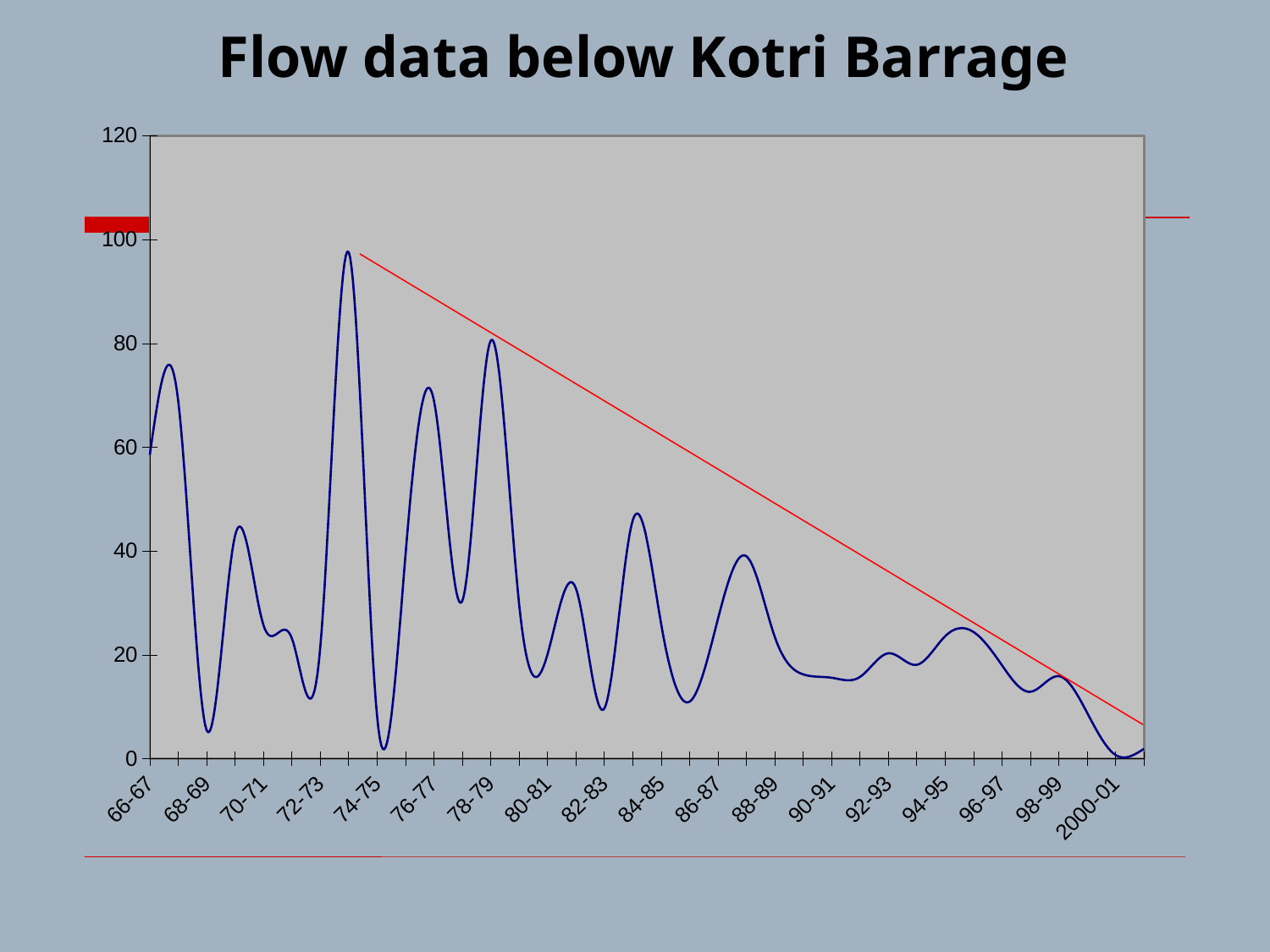
Overall, do the flow values rise or fall from 66-67 to 2000-01? fall Is the value for 74-75 greater or less than 80? less How many year labels are shown on the x axis? 18 Which has the larger value, 74-75 or 78-79? 78-79 What is the title of the chart? Flow data below Kotri Barrage What kind of chart is shown on the slide? line chart Which has the larger value, 68-69 or 70-71? 70-71 Is the value for 2000-01 greater or less than 20? less Is the value for 76-77 greater or less than 60? greater